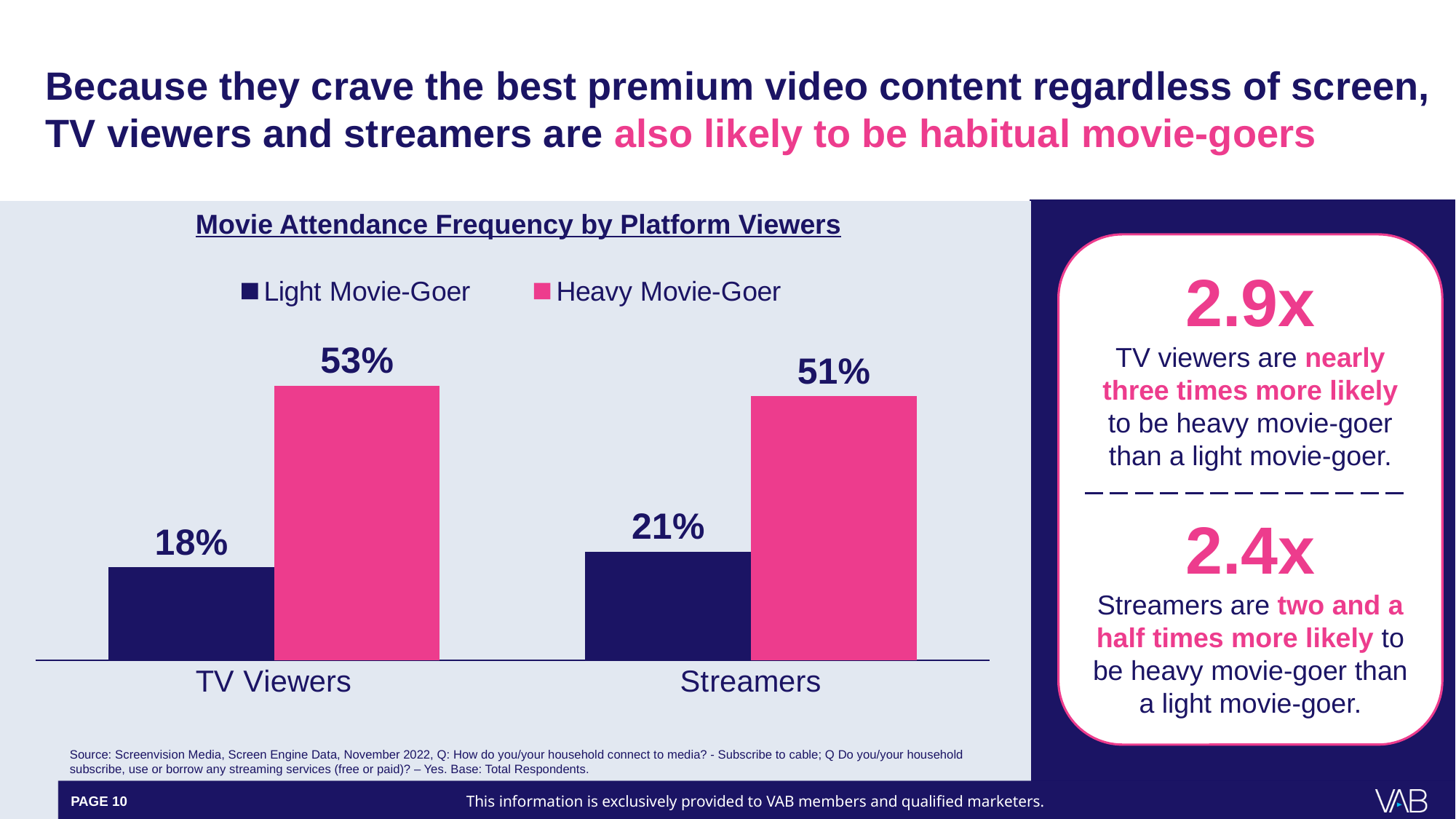
What is the value for Heavy Movie-Goer among TV Viewers? 53% What is the value for Heavy Movie-Goer among Streamers? 51% How many categories are shown on the x axis? 2 Which category has the lowest Light Movie-Goer value? TV Viewers What is the value for Light Movie-Goer among Streamers? 21% What is the difference between the Heavy Movie-Goer and Light Movie-Goer values for Streamers? 30% Which category has the highest Heavy Movie-Goer value? TV Viewers Which is larger: the Light Movie-Goer value for TV Viewers or for Streamers? Streamers What is the value for Light Movie-Goer among TV Viewers? 18% How many series does the legend list? 2 What is the difference between the Heavy Movie-Goer and Light Movie-Goer values for TV Viewers? 35% What kind of chart is shown on the slide? Bar chart